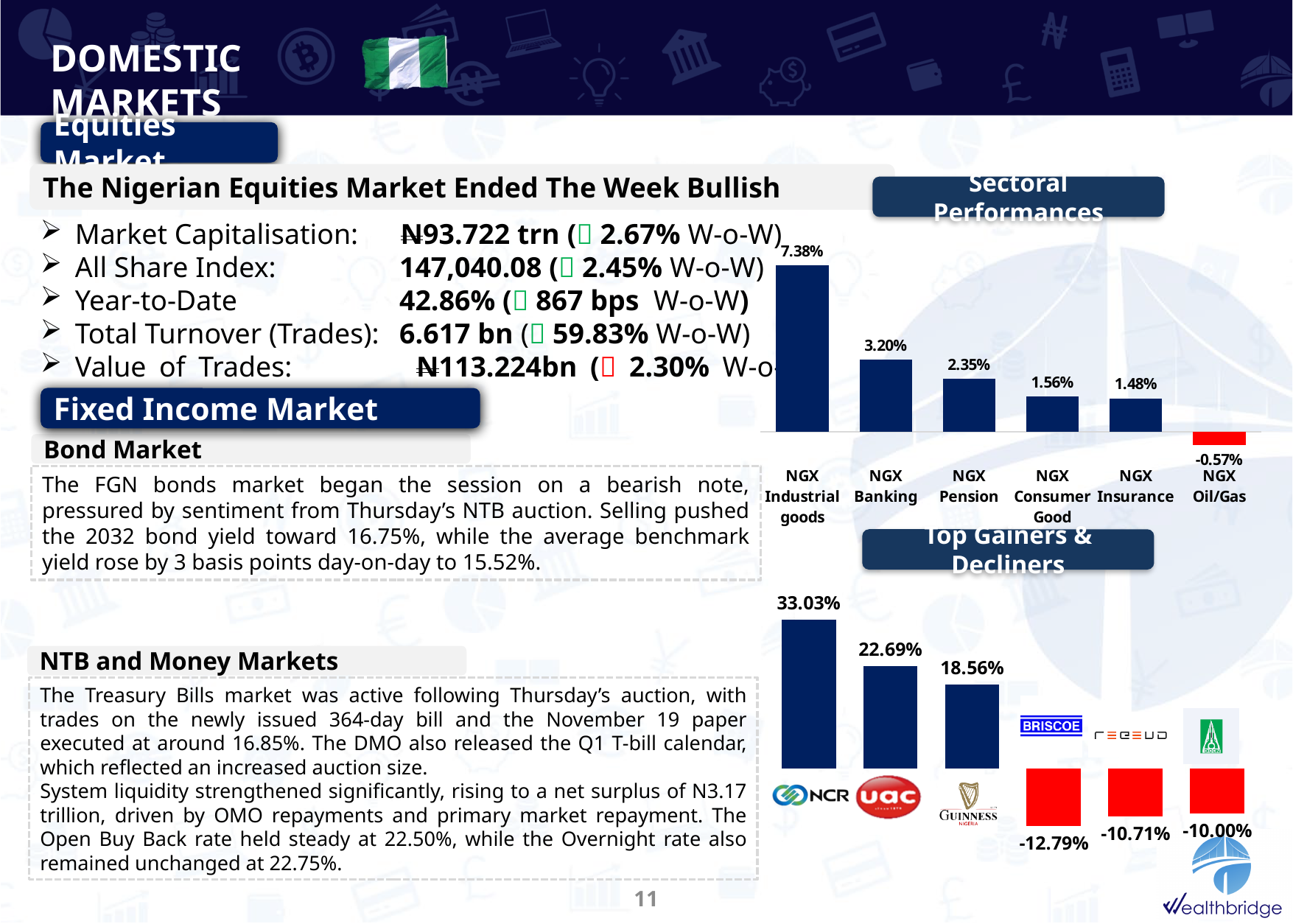
In the Top Gainers & Decliners chart, what is the largest decline shown? -12.79% In the Top Gainers & Decliners chart, what is the highest gain shown? 33.03% In the Sectoral Performances chart, do the values rise or fall from left to right? Fall In the Sectoral Performances chart, which sector has the highest value? NGX Industrial goods In the Top Gainers & Decliners chart, what colour are the bars for the decliners? Red In the Sectoral Performances chart, what is the value for NGX Banking? 3.20% How many sectors are shown in the Sectoral Performances chart? 6 In the Sectoral Performances chart, what is the value for NGX Oil/Gas? -0.57% In the Sectoral Performances chart, which is larger, NGX Pension or NGX Consumer Good? NGX Pension What kind of chart is the Sectoral Performances chart? Bar chart In the Sectoral Performances chart, what is the difference between NGX Industrial goods and NGX Banking? 4.18% In the Sectoral Performances chart, which sector has the lowest value? NGX Oil/Gas